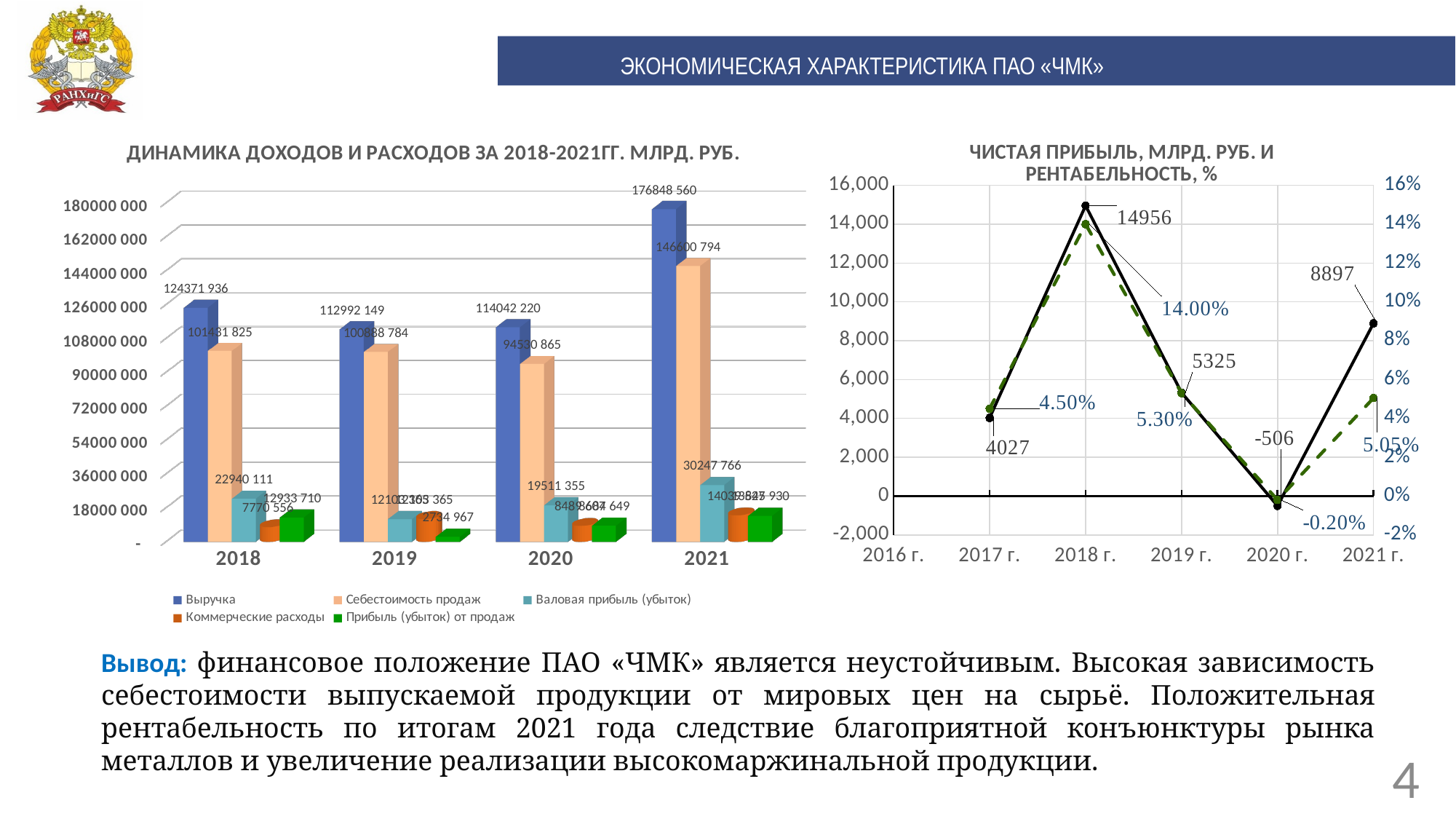
On the right chart (ЧИСТАЯ ПРИБЫЛЬ И РЕНТАБЕЛЬНОСТЬ), what is the net profit value for 2018 г.? 14956 What kind of chart is the left chart (ДИНАМИКА ДОХОДОВ И РАСХОДОВ)? bar chart On the right chart (ЧИСТАЯ ПРИБЫЛЬ И РЕНТАБЕЛЬНОСТЬ), in which year is net profit the lowest? 2020 г. On the right chart (ЧИСТАЯ ПРИБЫЛЬ И РЕНТАБЕЛЬНОСТЬ), what is the profitability (рентабельность) value for 2020 г.? -0.20% On the left chart (ДИНАМИКА ДОХОДОВ И РАСХОДОВ), in which year is Выручка the highest? 2021 On the left chart (ДИНАМИКА ДОХОДОВ И РАСХОДОВ), how many years are shown on the x axis? 4 On the left chart (ДИНАМИКА ДОХОДОВ И РАСХОДОВ), what is the value of Себестоимость продаж for 2018? 101431 825 On the left chart (ДИНАМИКА ДОХОДОВ И РАСХОДОВ), how many series does the legend list? 5 On the left chart (ДИНАМИКА ДОХОДОВ И РАСХОДОВ), what is the value of Прибыль (убыток) от продаж for 2019? 2734 967 On the right chart (ЧИСТАЯ ПРИБЫЛЬ И РЕНТАБЕЛЬНОСТЬ), what is the difference between net profit in 2018 г. and 2019 г.? 9631 On the left chart (ДИНАМИКА ДОХОДОВ И РАСХОДОВ), what is the value of Выручка for 2021? 176848 560 On the left chart (ДИНАМИКА ДОХОДОВ И РАСХОДОВ), what is the value of Валовая прибыль (убыток) for 2020? 19511 355